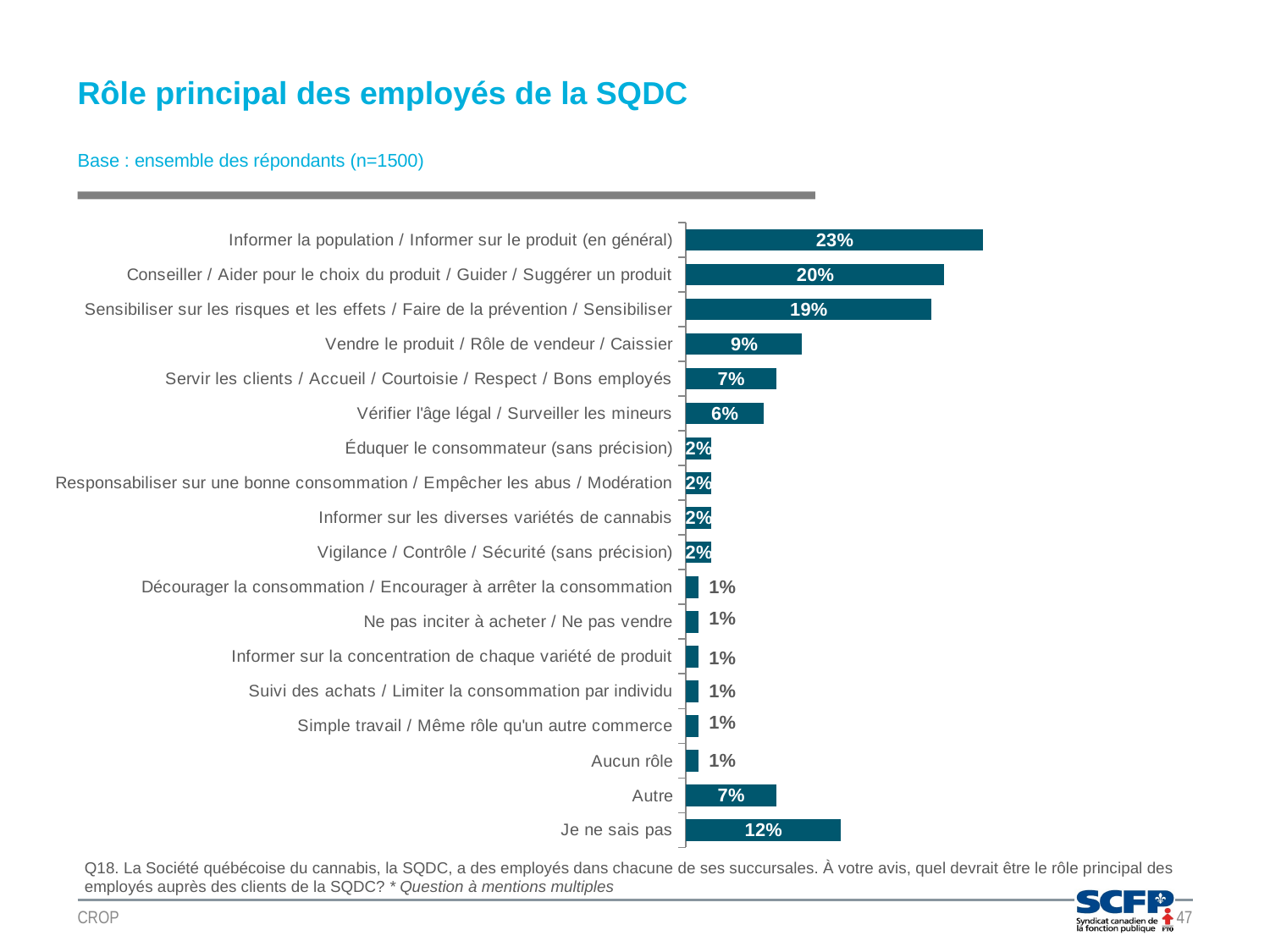
What percentage is shown for "Vendre le produit / Rôle de vendeur / Caissier"? 9% Which category has the highest value? Informer la population / Informer sur le produit (en général) What is the difference between the values for "Informer la population / Informer sur le produit (en général)" and "Je ne sais pas"? 11% What is the value for "Vérifier l'âge légal / Surveiller les mineurs"? 6% How many categories are plotted in the chart? 18 What is the value for "Je ne sais pas"? 12% What is the difference between "Conseiller / Aider pour le choix du produit / Guider / Suggérer un produit" and "Sensibiliser sur les risques et les effets / Faire de la prévention / Sensibiliser"? 1% What is the title of the slide containing the chart? Rôle principal des employés de la SQDC What percentage is shown for "Autre"? 7% What type of chart is shown on the slide? Bar chart What percentage is shown for "Informer la population / Informer sur le produit (en général)"? 23% Which is larger: the value for "Servir les clients / Accueil / Courtoisie / Respect / Bons employés" or the value for "Vérifier l'âge légal / Surveiller les mineurs"? Servir les clients / Accueil / Courtoisie / Respect / Bons employés